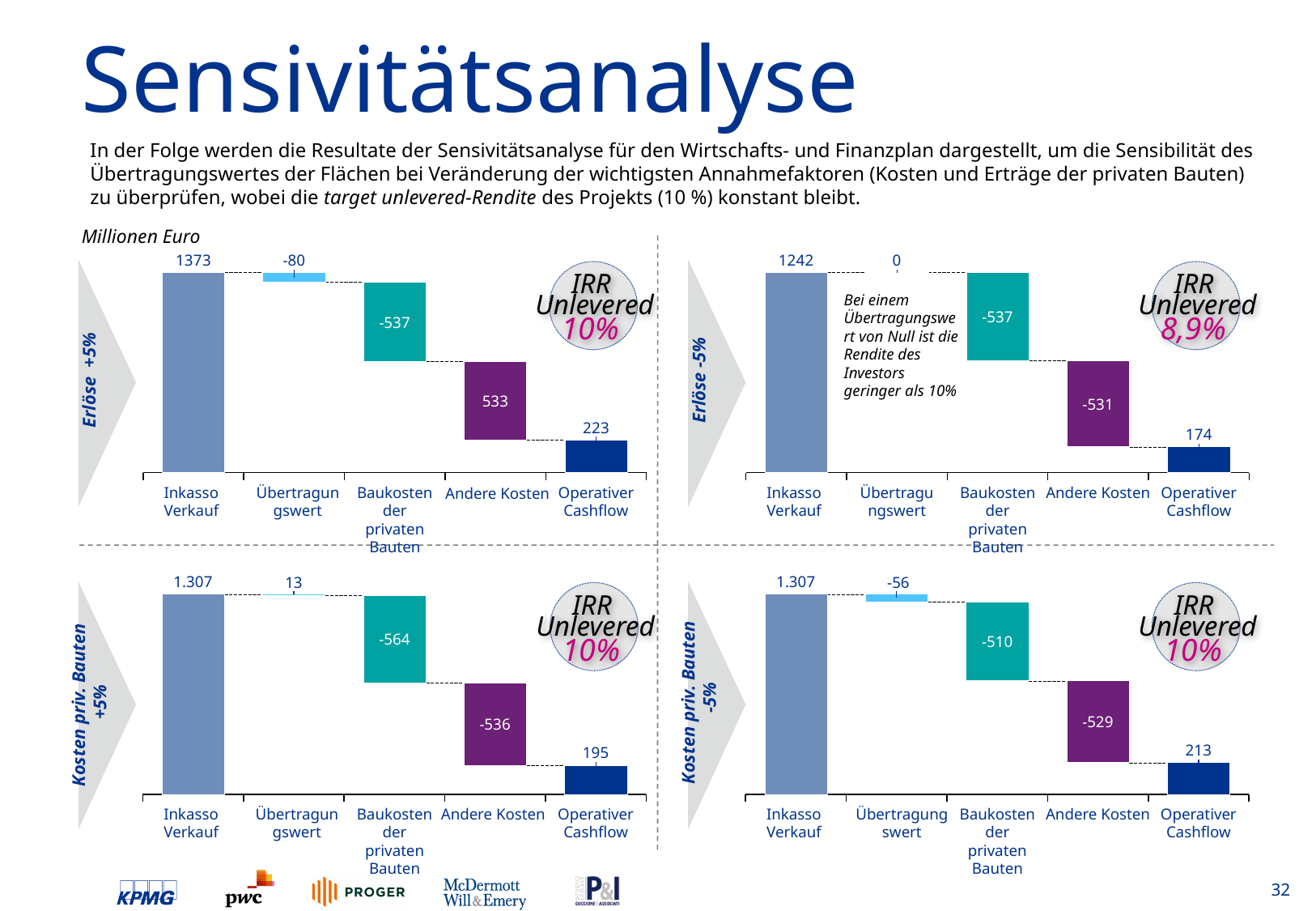
What IRR Unlevered value is shown for the 'Erlöse -5%' chart (top right)? 8,9% How many categories are shown on the x axis of the 'Erlöse +5%' chart (top left)? 5 What kind of chart is used in each of the four panels on the slide? Bar chart (waterfall) In the 'Erlöse +5%' chart (top left), what is the value for Übertragungswert? -80 In the 'Kosten priv. Bauten +5%' chart (bottom left), what is the value for Baukosten der privaten Bauten? -564 In the 'Kosten priv. Bauten -5%' chart (bottom right), what is the value for Andere Kosten? -529 In the 'Erlöse -5%' chart (top right), what is the value for Operativer Cashflow? 174 Which chart shows the higher Operativer Cashflow: 'Kosten priv. Bauten +5%' (bottom left) or 'Kosten priv. Bauten -5%' (bottom right)? Kosten priv. Bauten -5% In the 'Erlöse -5%' chart (top right), what is the value for Übertragungswert? 0 In the 'Kosten priv. Bauten -5%' chart (bottom right), what is the value for Operativer Cashflow? 213 In the 'Erlöse +5%' chart (top left), what is the value for Inkasso Verkauf? 1373 What is the difference between the Operativer Cashflow in the 'Erlöse +5%' chart (223) and in the 'Erlöse -5%' chart (174)? 49